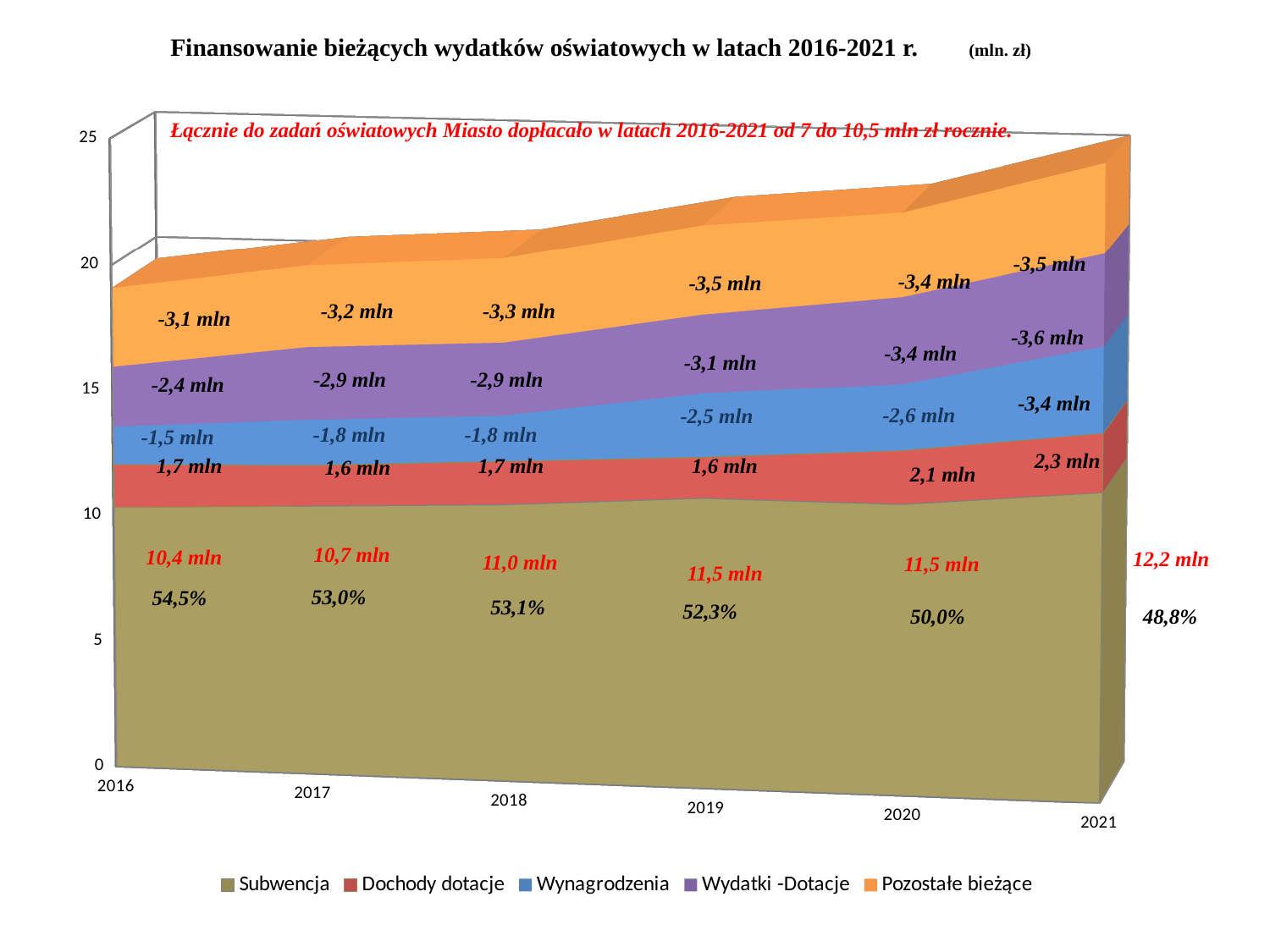
What is the value of Subwencja for 2021? 12,2 mln What is the value of Wydatki -Dotacje for 2017? -2,9 mln What kind of chart is shown on the slide? Area chart What is the value of Pozostałe bieżące for 2016? -3,1 mln What is the difference between the Subwencja values for 2021 and 2016? 1,8 mln In which year is the Subwencja value highest? 2021 In which year is the Subwencja percentage lowest? 2021 How many series does the legend list? 5 What is the value of Dochody dotacje for 2020? 2,1 mln What is the value of Wynagrodzenia for 2019? -2,5 mln What percentage is shown for Subwencja in 2016? 54,5% Which is larger, the Dochody dotacje value for 2021 or for 2016? 2021